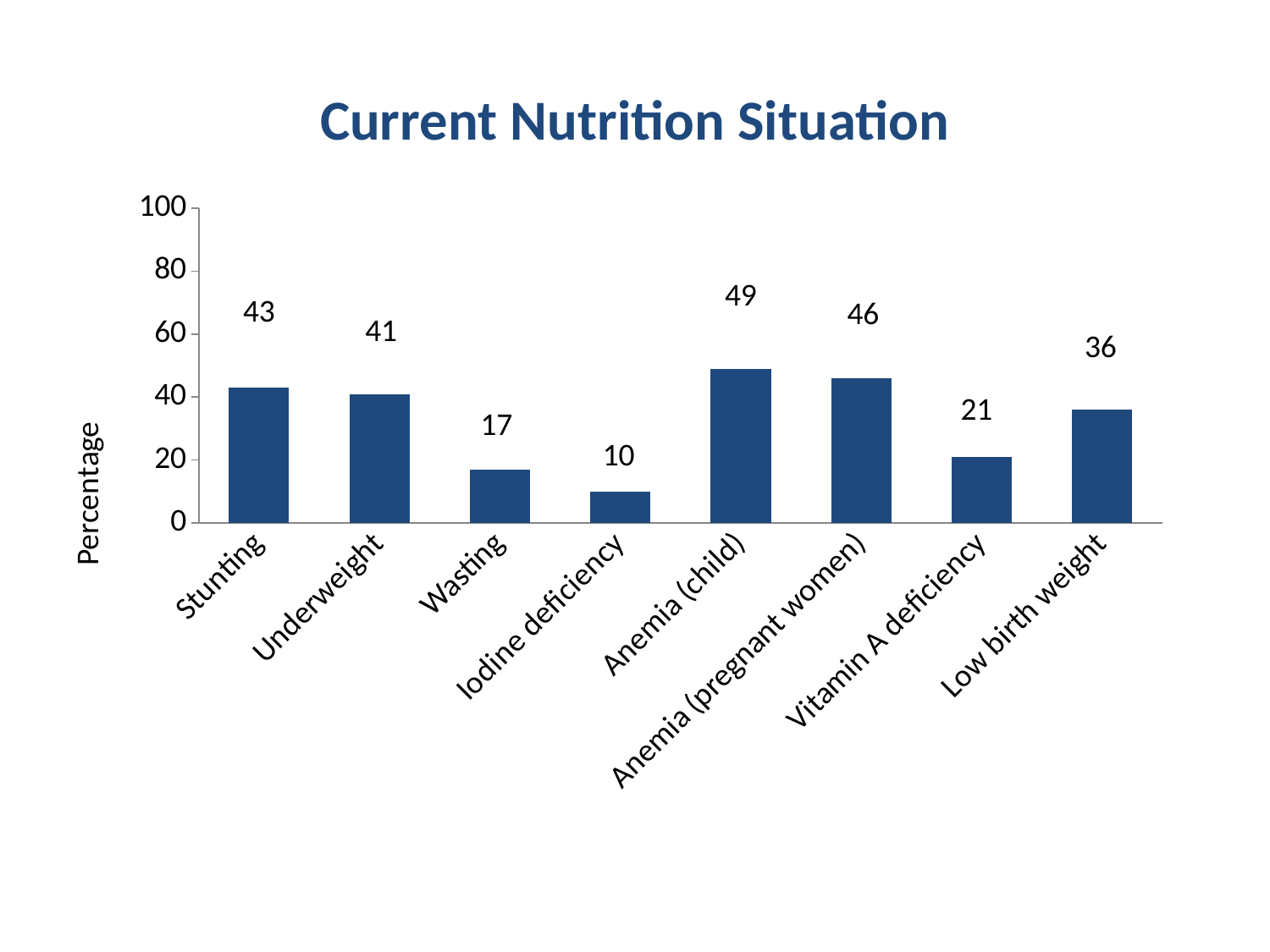
What is the value for Stunting? 43 What is the value for Anemia (pregnant women)? 46 What is the label of the vertical axis? Percentage What is the value for Iodine deficiency? 10 Which is larger, the value for Underweight or the value for Low birth weight? Underweight Which category has the lowest value? Iodine deficiency How many categories are shown on the x axis? 8 What kind of chart is shown on the slide? bar chart What is the difference between the values for Anemia (child) and Vitamin A deficiency? 28 Is the value for Wasting greater or less than 20? less What is the value for Low birth weight? 36 Which category has the highest value? Anemia (child)